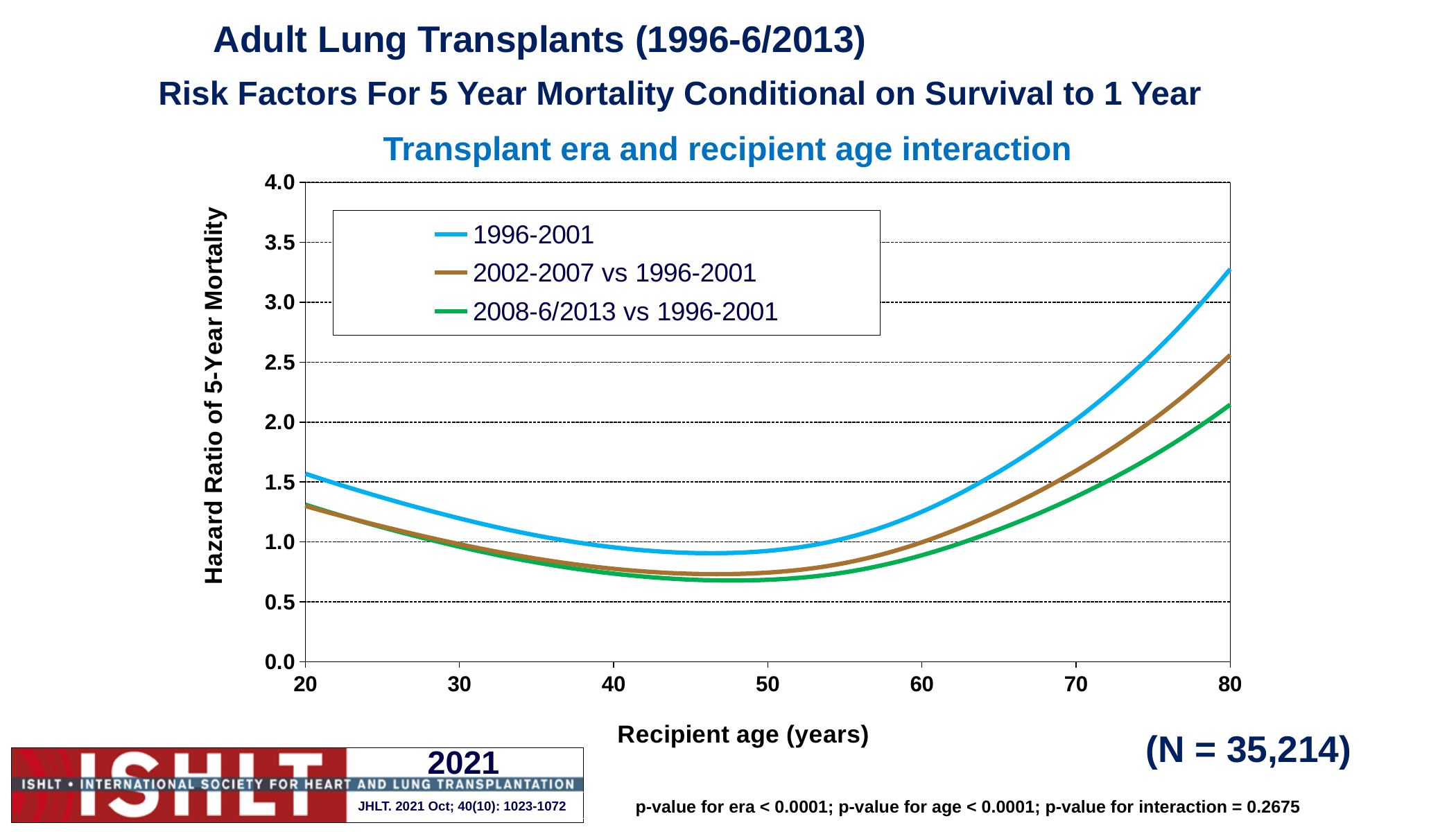
What kind of chart is shown on the slide? Line chart At recipient age 80, which is larger: the hazard ratio for 1996-2001 or for 2008-6/2013 vs 1996-2001? 1996-2001 What is the label of the y axis? Hazard Ratio of 5-Year Mortality At recipient age 80, is the hazard ratio for 1996-2001 greater or less than 3.0? greater What is the subtitle of the chart? Transplant era and recipient age interaction Which series has the lowest hazard ratio at recipient age 80? 2008-6/2013 vs 1996-2001 How many series does the legend list? 3 Which series has the highest hazard ratio at recipient age 80? 1996-2001 At recipient age 50, is the hazard ratio for 1996-2001 greater or less than 1.0? less At recipient age 70, is the hazard ratio for 2008-6/2013 vs 1996-2001 greater or less than 1.5? less Do the hazard ratios rise or fall as recipient age increases from 50 to 80? Rise